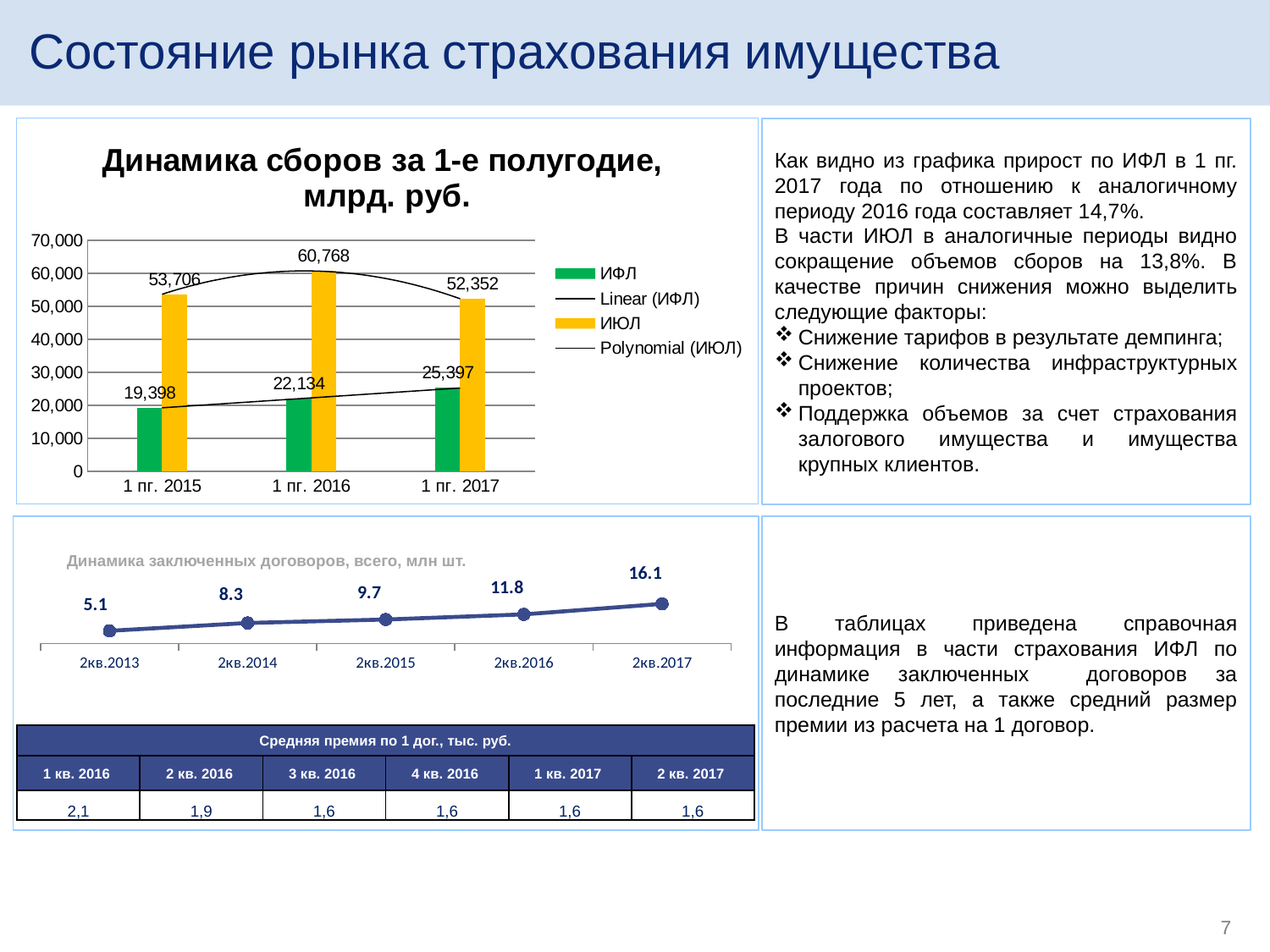
In the chart 'Динамика заключенных договоров, всего, млн шт.', what is the value for 2кв.2017? 16.1 In the chart 'Динамика заключенных договоров, всего, млн шт.', what is the difference between the values for 2кв.2016 and 2кв.2013? 6.7 In the chart 'Динамика сборов за 1-е полугодие, млрд. руб.', which is larger in 1 пг. 2015: ИФЛ or ИЮЛ? ИЮЛ In the chart 'Динамика сборов за 1-е полугодие, млрд. руб.', what is the value for ИЮЛ in 1 пг. 2016? 60,768 In the chart 'Динамика сборов за 1-е полугодие, млрд. руб.', how many entries does the legend list? 4 In the chart 'Динамика сборов за 1-е полугодие, млрд. руб.', do the ИФЛ values rise or fall from 1 пг. 2015 to 1 пг. 2017? Rise In the chart 'Динамика сборов за 1-е полугодие, млрд. руб.', what is the difference between the ИЮЛ values for 1 пг. 2016 and 1 пг. 2017? 8,416 In the chart 'Динамика сборов за 1-е полугодие, млрд. руб.', in which period is the ИЮЛ value highest? 1 пг. 2016 In the chart 'Динамика сборов за 1-е полугодие, млрд. руб.', what is the value for ИФЛ in 1 пг. 2017? 25,397 In the chart 'Динамика сборов за 1-е полугодие, млрд. руб.', in which period is the ИФЛ value lowest? 1 пг. 2015 In the chart 'Динамика заключенных договоров, всего, млн шт.', how many data points are plotted? 5 What kind of chart is 'Динамика сборов за 1-е полугодие, млрд. руб.'? Bar chart